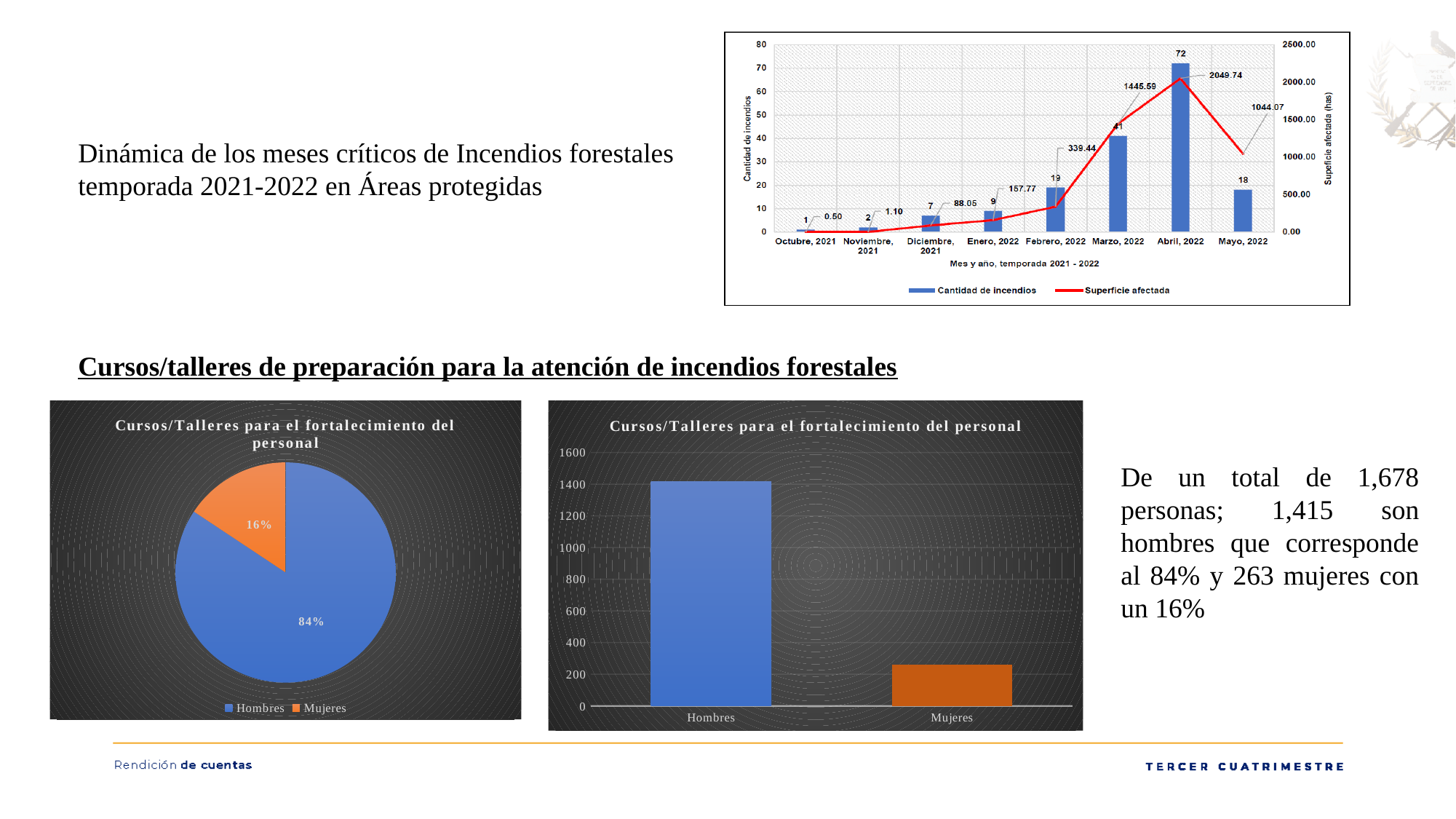
In the top-right chart on forest fires, how many fires (Cantidad de incendios) were recorded in Abril, 2022? 72 In the bottom-middle chart titled 'Cursos/Talleres para el fortalecimiento del personal', is the value for Hombres greater or less than 1200? greater In the top-right chart on forest fires, what was the affected area (Superficie afectada) in Marzo, 2022? 1445.59 In the top-right chart on forest fires, which month had the lowest affected area? Octubre, 2021 What kind of chart is the bottom-middle chart titled 'Cursos/Talleres para el fortalecimiento del personal'? bar chart In the top-right chart on forest fires, which month had the highest number of fires? Abril, 2022 In the bottom-left pie chart, which category has the larger slice? Hombres In the top-right chart on forest fires, which had more fires: Febrero, 2022 or Marzo, 2022? Marzo, 2022 In the top-right chart on forest fires, how many months are shown on the x axis? 8 In the top-right chart on forest fires, how many series does the legend list? 2 In the bottom-left pie chart, what share of the pie is Mujeres? 16% In the top-right chart on forest fires, what is the difference in the number of fires between Abril, 2022 and Mayo, 2022? 54